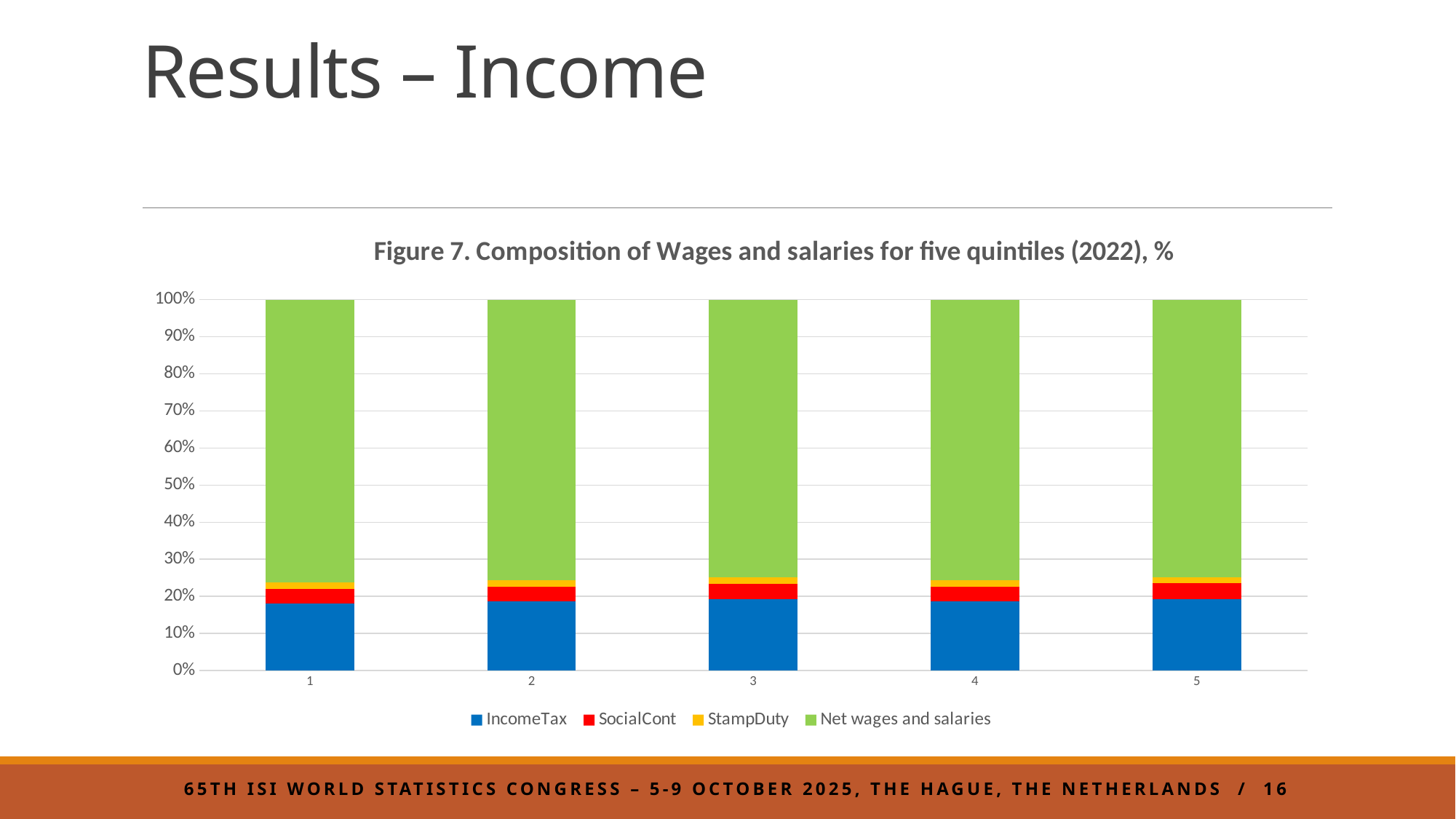
Which series makes up the smallest share of the bar for quintile 4? StampDuty How many series does the legend list? 4 How many quintiles (bars) are shown on the x axis? 5 Is the IncomeTax value for quintile 3 greater or less than 10%? greater Which series makes up the largest share of the bar for quintile 2? Net wages and salaries What kind of chart is shown on the slide? Stacked bar chart What is the total height of the stacked bar for quintile 1? 100% What is the title of the chart? Figure 7. Composition of Wages and salaries for five quintiles (2022), % Is the Net wages and salaries value for quintile 5 greater or less than 70%? greater Which series is shown in green in the chart? Net wages and salaries Is the IncomeTax value for quintile 1 greater or less than 20%? less In quintile 1, which is larger: the IncomeTax segment or the Net wages and salaries segment? Net wages and salaries